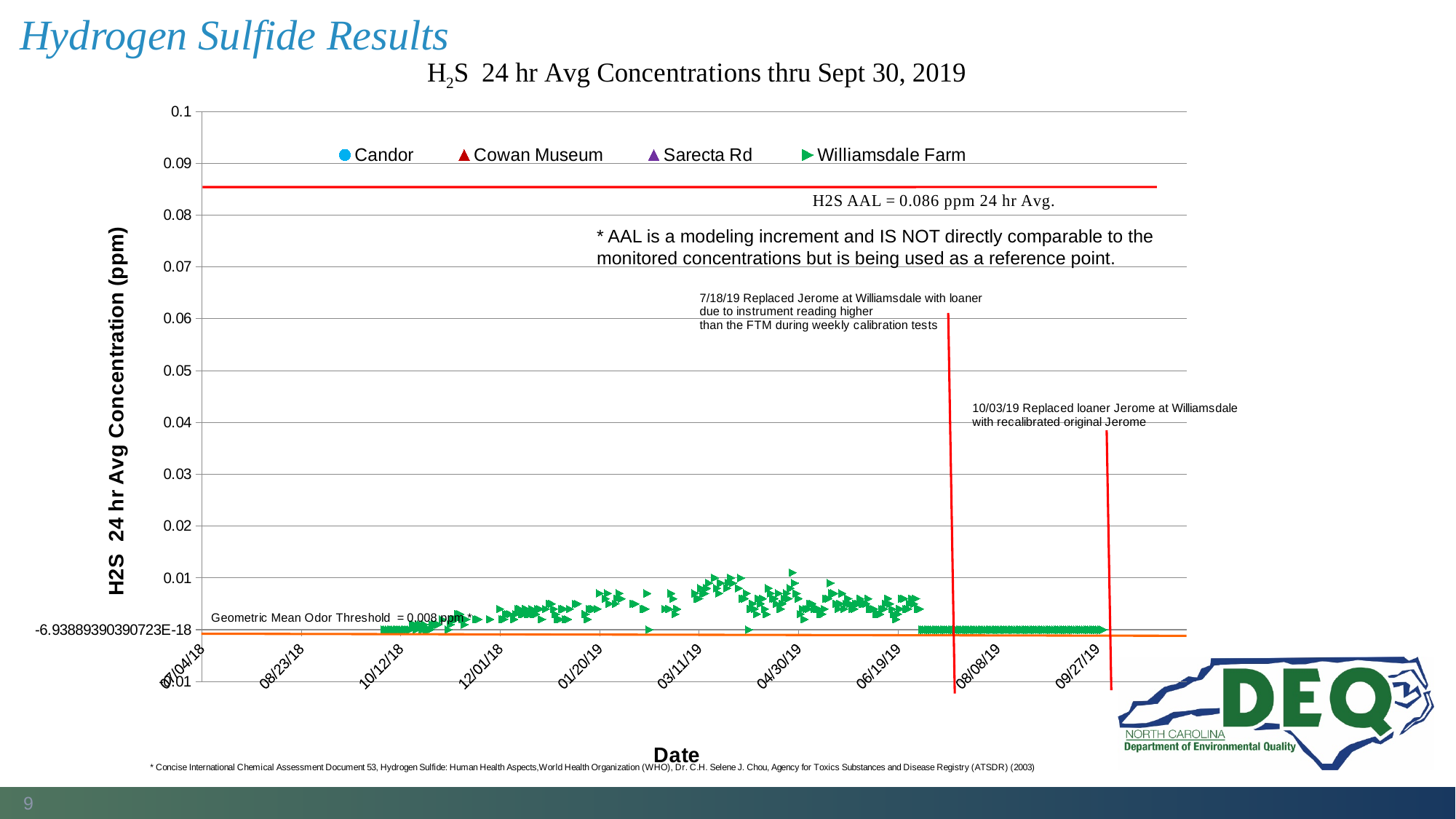
What kind of chart is shown on the slide? scatter chart What is the highest value shown on the y axis of the chart? 0.1 What is the H2S AAL value marked by the red horizontal line on the chart? 0.086 ppm 24 hr Avg. Which series in the legend has visible plotted data points on the chart? Williamsdale Farm How many series does the chart legend list? 4 On what date was the Jerome at Williamsdale replaced with a loaner, according to the chart annotation? 7/18/19 What is the title of the chart? H2S 24 hr Avg Concentrations thru Sept 30, 2019 Is the H2S AAL reference line greater or less than 0.08 on the y axis? greater Are the plotted Williamsdale Farm values greater or less than 0.02 ppm? less What is the Geometric Mean Odor Threshold value noted on the chart? 0.008 ppm Do the Williamsdale Farm values after the 7/18/19 instrument replacement line sit higher or lower than the values plotted before it? lower